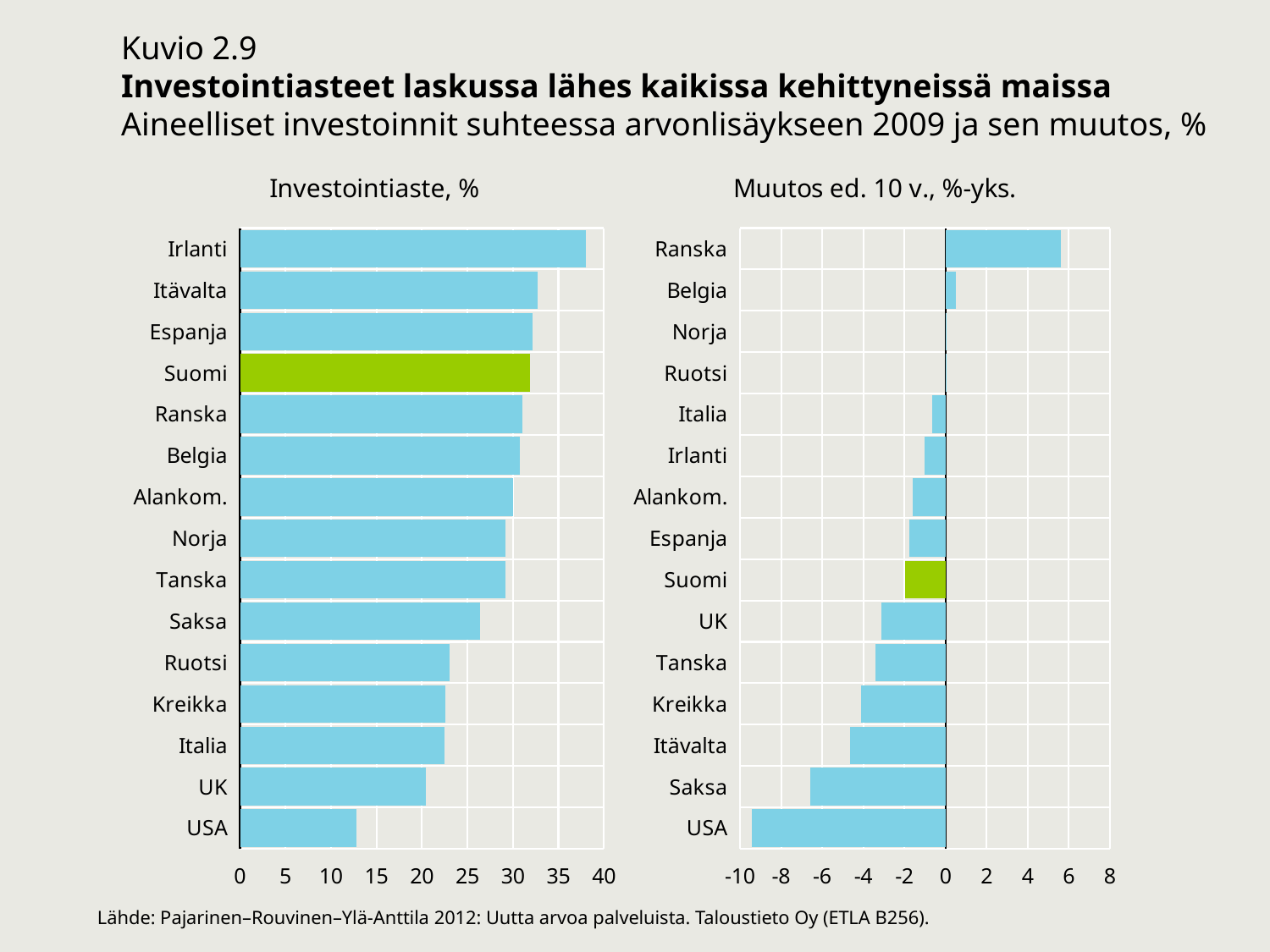
In the left chart "Investointiaste, %", which has a larger value, Saksa or Ruotsi? Saksa In the right chart "Muutos ed. 10 v., %-yks.", which country has the highest value? Ranska In the left chart "Investointiaste, %", which country has the highest value? Irlanti How many countries are shown in the left chart "Investointiaste, %"? 15 In the left chart "Investointiaste, %", which country has the lowest value? USA Which country's bars are highlighted in green in both charts? Suomi What kind of chart is the left chart titled "Investointiaste, %"? bar chart In the right chart "Muutos ed. 10 v., %-yks.", which country has the lowest value? USA In the left chart "Investointiaste, %", is the value for Irlanti greater or less than 35? greater In the right chart "Muutos ed. 10 v., %-yks.", is the value for Saksa greater or less than -4? less In the left chart "Investointiaste, %", is the value for USA greater or less than 15? less In the right chart "Muutos ed. 10 v., %-yks.", which has a larger value, Belgia or Itävalta? Belgia